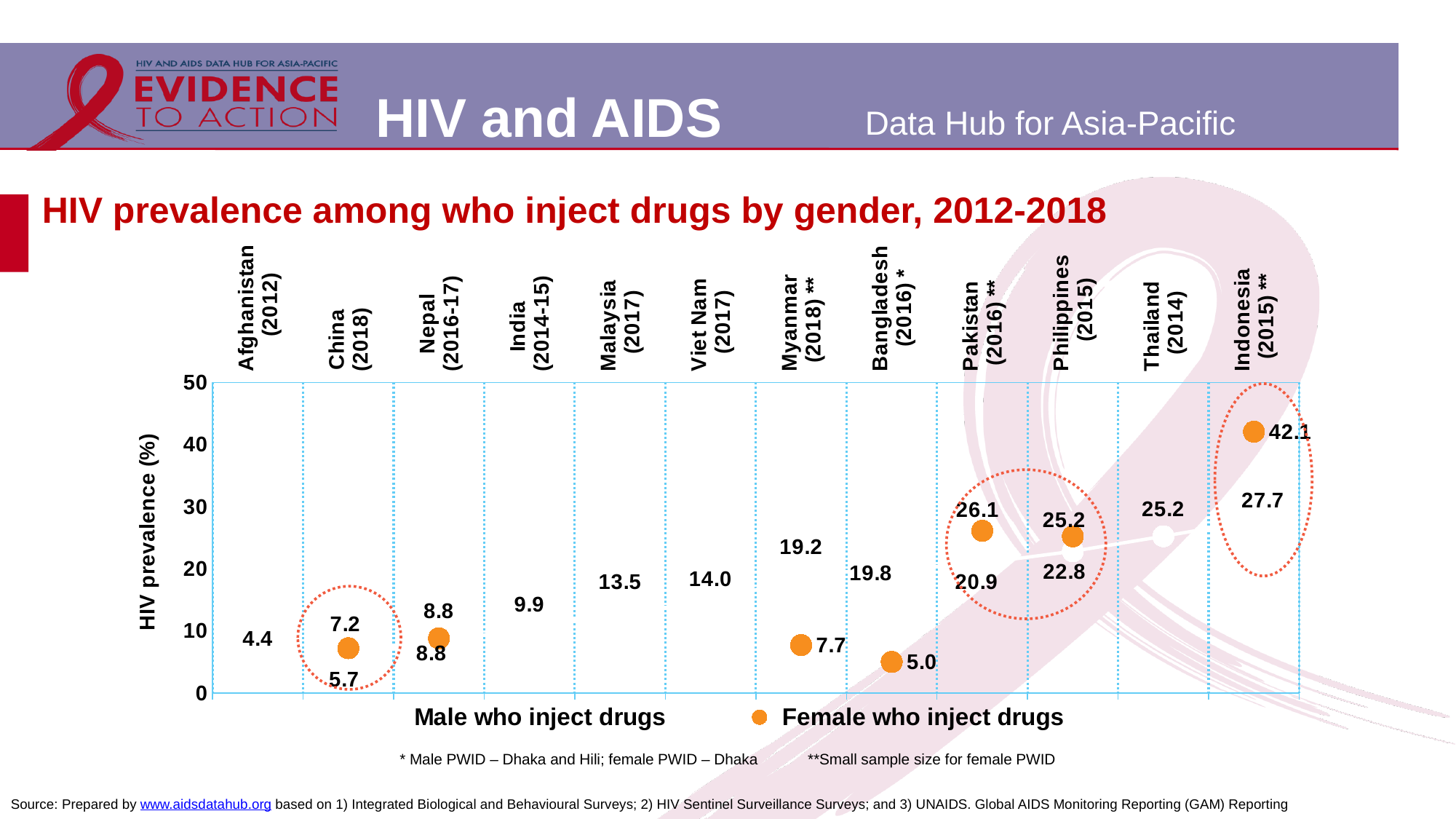
In Indonesia (2015), how much higher is the HIV prevalence among female who inject drugs than among male who inject drugs? 14.4 Which country has the lowest HIV prevalence among male who inject drugs? Afghanistan (2012) In Pakistan (2016), is HIV prevalence higher among male or female who inject drugs? Female who inject drugs What is the HIV prevalence among male who inject drugs in Thailand (2014)? 25.2 Which country has the highest HIV prevalence among female who inject drugs? Indonesia (2015) What is the HIV prevalence among female who inject drugs in Bangladesh (2016)? 5.0 What is the HIV prevalence among male who inject drugs in Afghanistan (2012)? 4.4 In Myanmar (2018), what is the difference between the HIV prevalence among male who inject drugs and female who inject drugs? 11.5 What is the HIV prevalence among female who inject drugs in Indonesia (2015)? 42.1 How many countries are shown on the chart? 12 How many series does the legend list? 2 What is the label of the vertical axis? HIV prevalence (%)